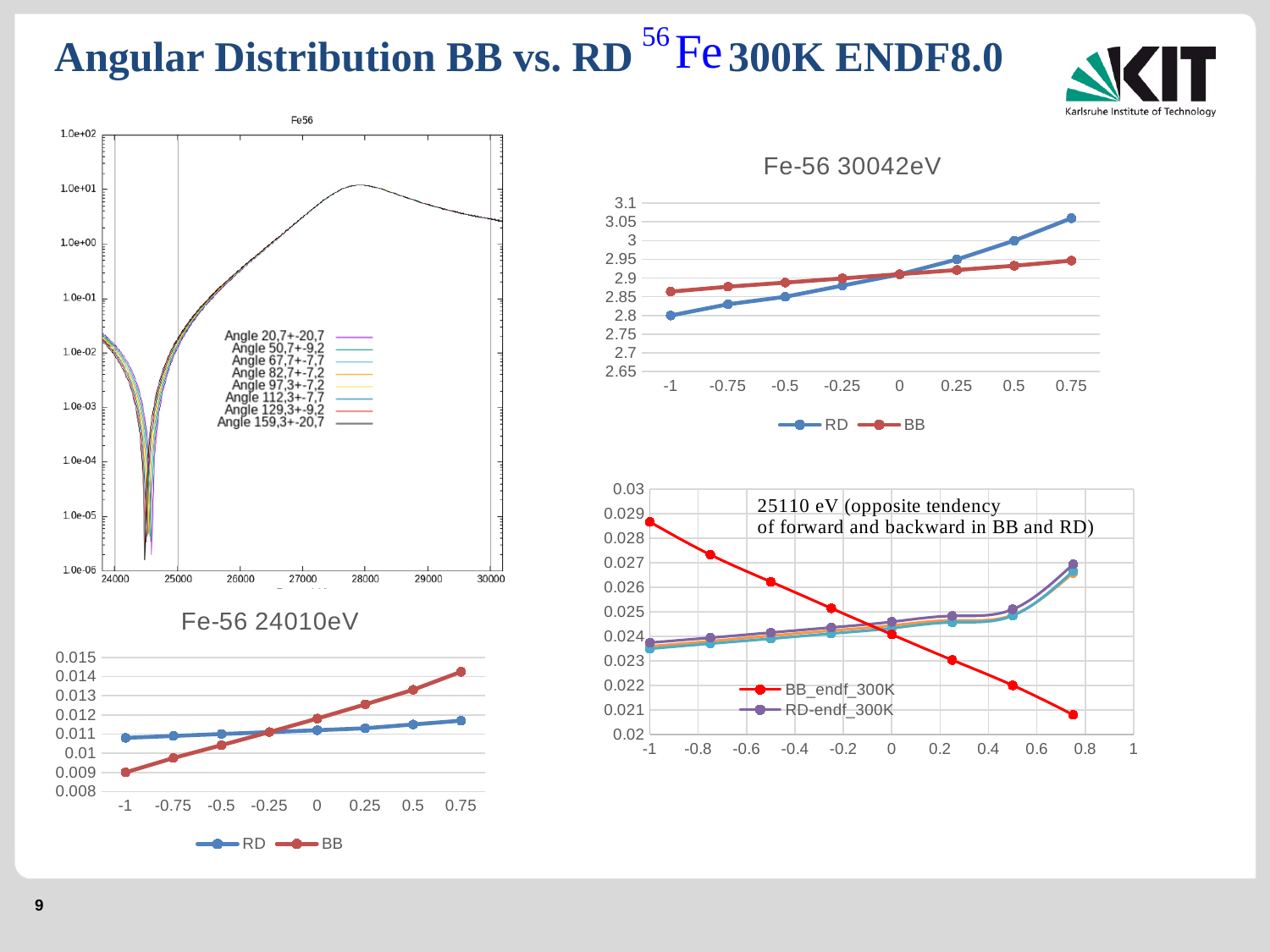
How many series does the legend of the 'Fe-56 30042eV' chart list? 2 In the bottom-right chart (25110 eV), does the BB_endf_300K series rise or fall as x increases? fall In the 'Fe-56 24010eV' chart, which series has the larger value at x = 0.75, RD or BB? BB What kind of chart is the 'Fe-56 30042eV' chart? line chart In the 'Fe-56 30042eV' chart, which series has the larger value at x = -1, RD or BB? BB In the 'Fe-56 30042eV' chart, is the RD value at x = 0.75 greater or less than 3? greater In the 'Fe-56 30042eV' chart, does the RD series rise or fall as x goes from -1 to 0.75? rise How many data points does the RD series have in the 'Fe-56 30042eV' chart? 8 In the 'Fe-56 24010eV' chart, is the BB value at x = -1 greater or less than 0.01? less In the bottom-right chart (25110 eV), is the BB_endf_300K value at x = -1 greater or less than 0.028? greater How many angle entries does the legend of the top-left 'Fe56' chart list? 8